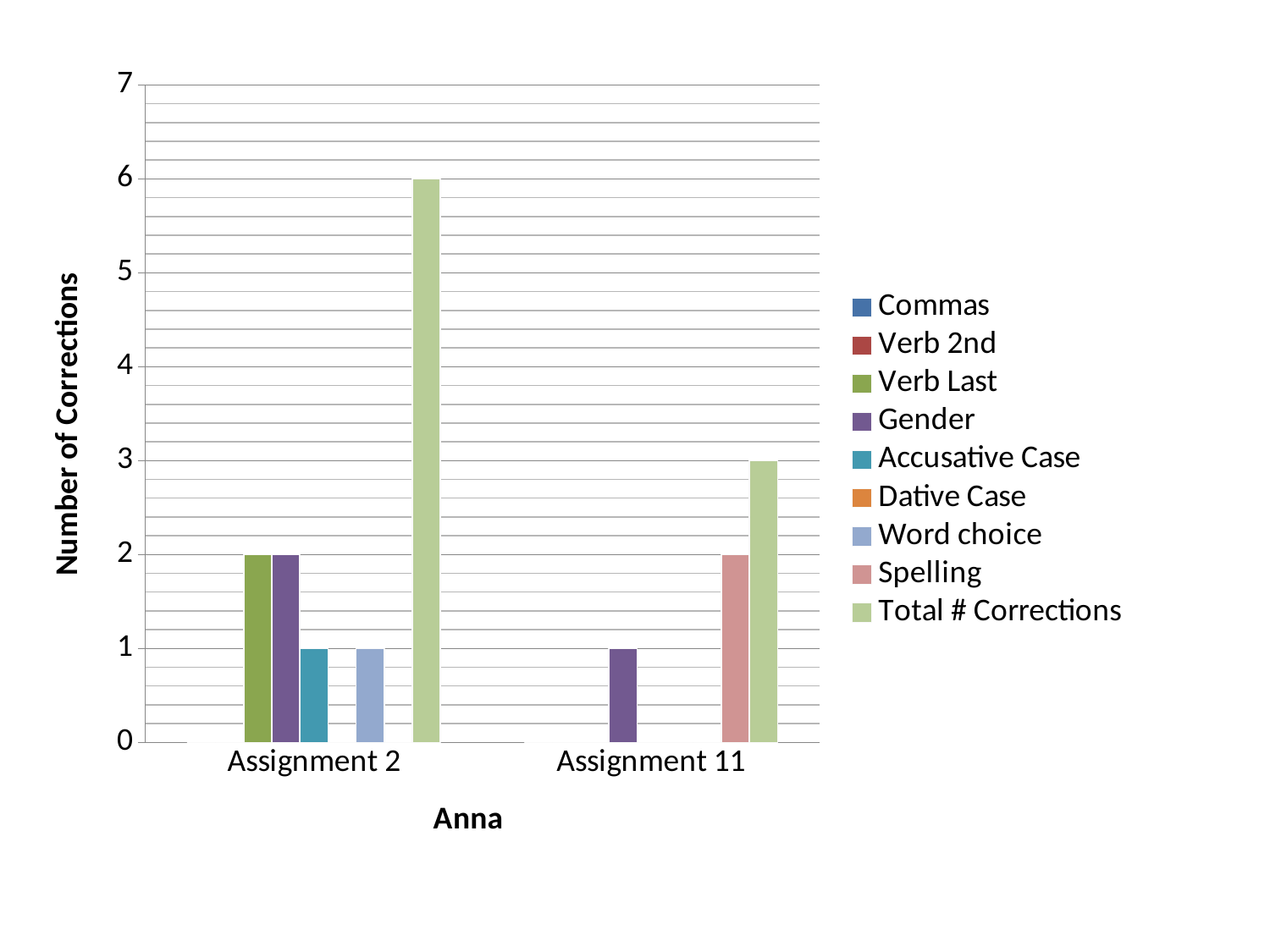
How many categories are shown on the x axis? 2 What is the Accusative Case value for Assignment 2? 1 What is the Gender value for Assignment 11? 1 What is the label of the y axis? Number of Corrections Does the Total # Corrections value fall or rise from Assignment 2 to Assignment 11? fall How many series does the legend list? 9 What is the Spelling value for Assignment 11? 2 What type of chart is shown on the slide? bar chart What is the Total # Corrections value for Assignment 11? 3 Which category has the higher Total # Corrections, Assignment 2 or Assignment 11? Assignment 2 What is the Total # Corrections value for Assignment 2? 6 What is the difference in Total # Corrections between Assignment 2 and Assignment 11? 3